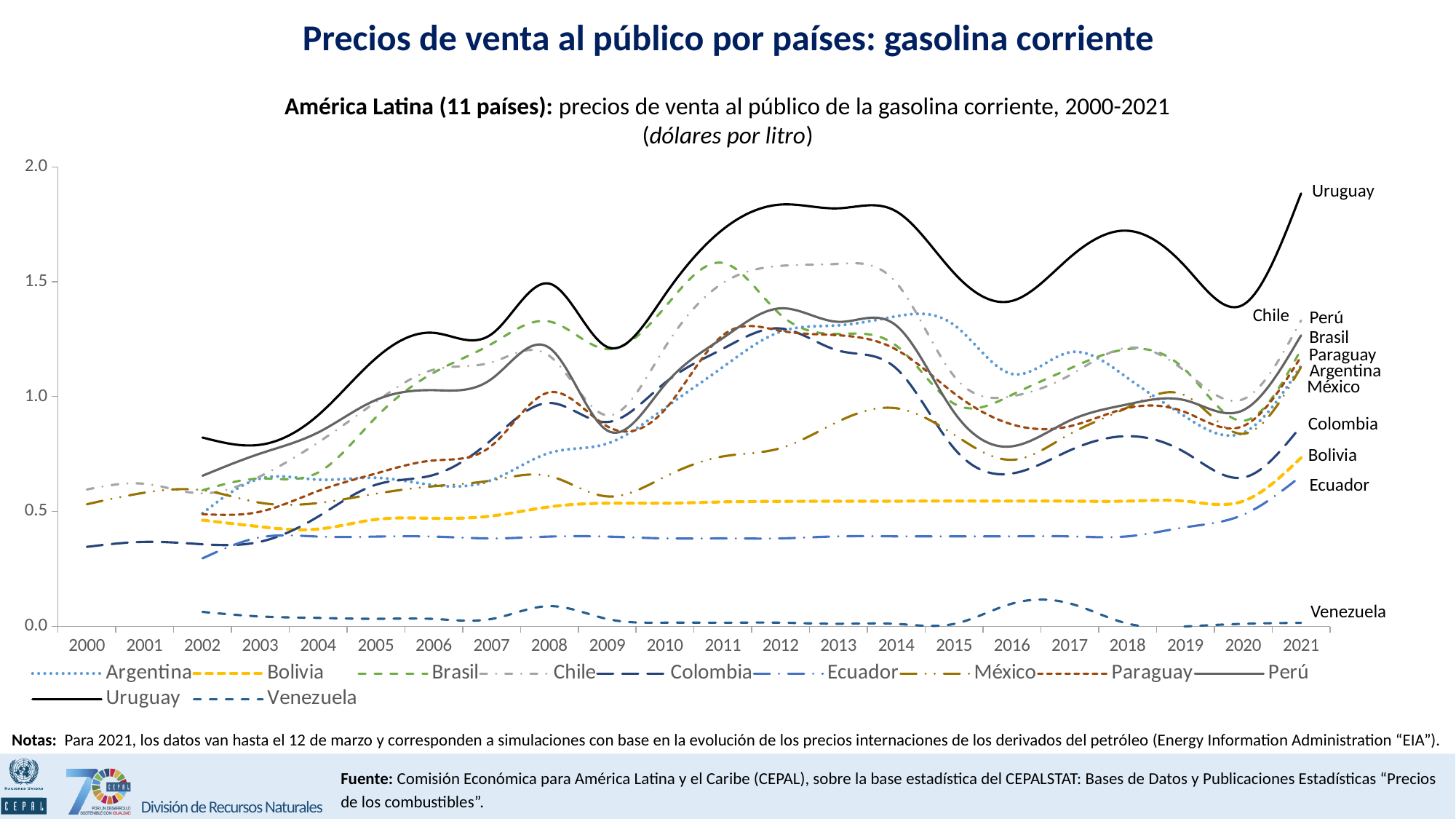
Is the value for Ecuador in 2010 greater or less than 0.5? less Which country has the highest gasoline price in 2021? Uruguay Does the value for Uruguay rise or fall from 2016 to 2018? rise Is the value for Venezuela in 2021 greater or less than 0.5? less How many countries (series) does the legend list? 11 What kind of chart is shown on the slide? line chart In 2021, which is larger: the value for Uruguay or the value for Colombia? Uruguay Is the value for Uruguay in 2021 greater or less than 1.5? greater How many years are shown along the x axis? 22 What unit are the prices expressed in, according to the chart subtitle? dólares por litro Which country has the lowest gasoline price in 2021? Venezuela